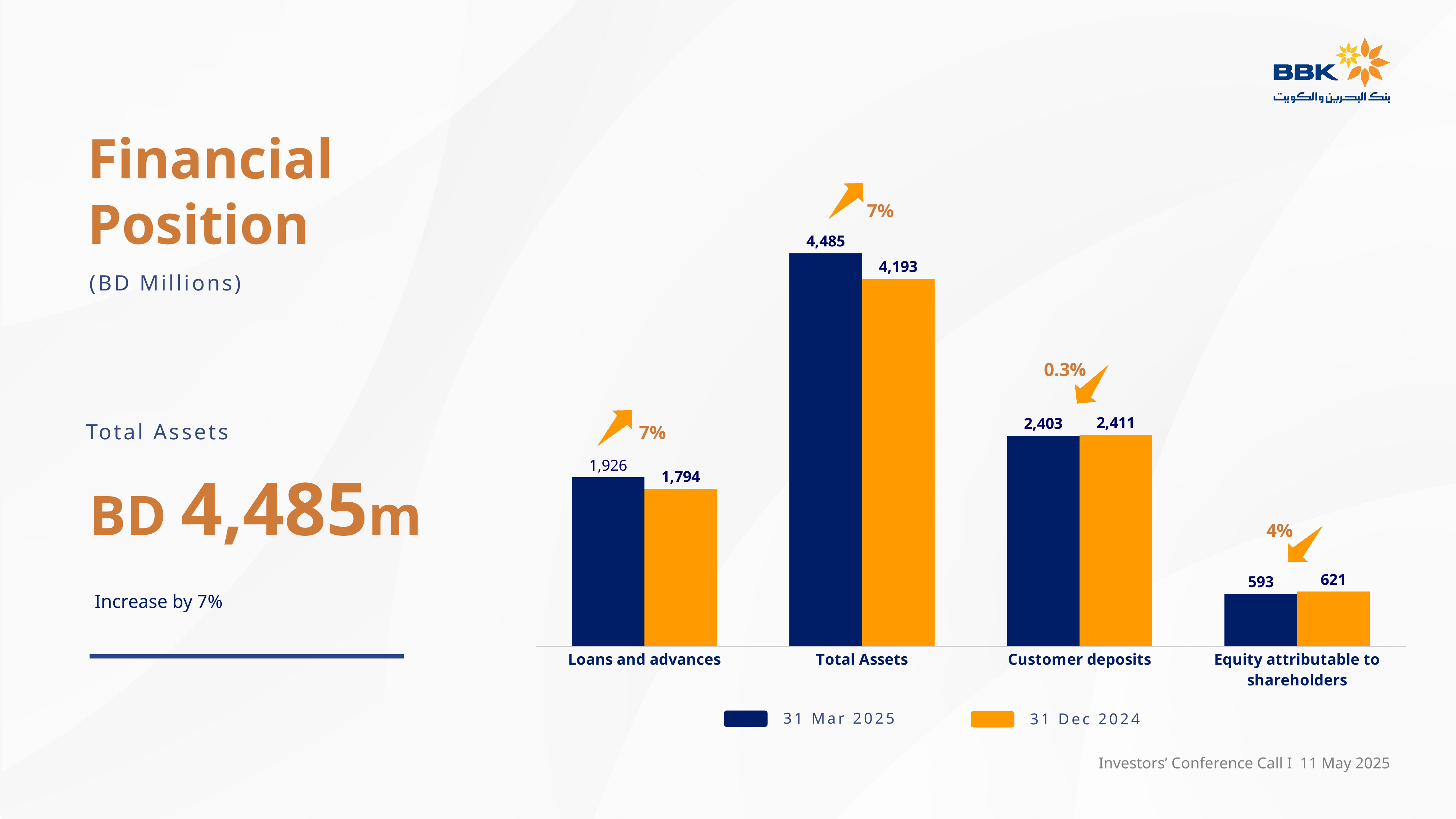
What kind of chart is shown on the slide? Bar chart How many categories are shown on the x axis of the chart? 4 What is the value for Total Assets at 31 Mar 2025? 4,485 What is the difference between the 31 Mar 2025 and 31 Dec 2024 values for Total Assets? 292 How many series does the legend list? 2 What is the value for Customer deposits at 31 Mar 2025? 2,403 What is the value for Loans and advances at 31 Dec 2024? 1,794 What is the difference between the 31 Mar 2025 and 31 Dec 2024 values for Loans and advances? 132 Which category has the highest value for 31 Mar 2025? Total Assets Which category has the lowest value for 31 Dec 2024? Equity attributable to shareholders What is the value for Equity attributable to shareholders at 31 Dec 2024? 621 Which is larger for Equity attributable to shareholders: the 31 Mar 2025 value or the 31 Dec 2024 value? 31 Dec 2024